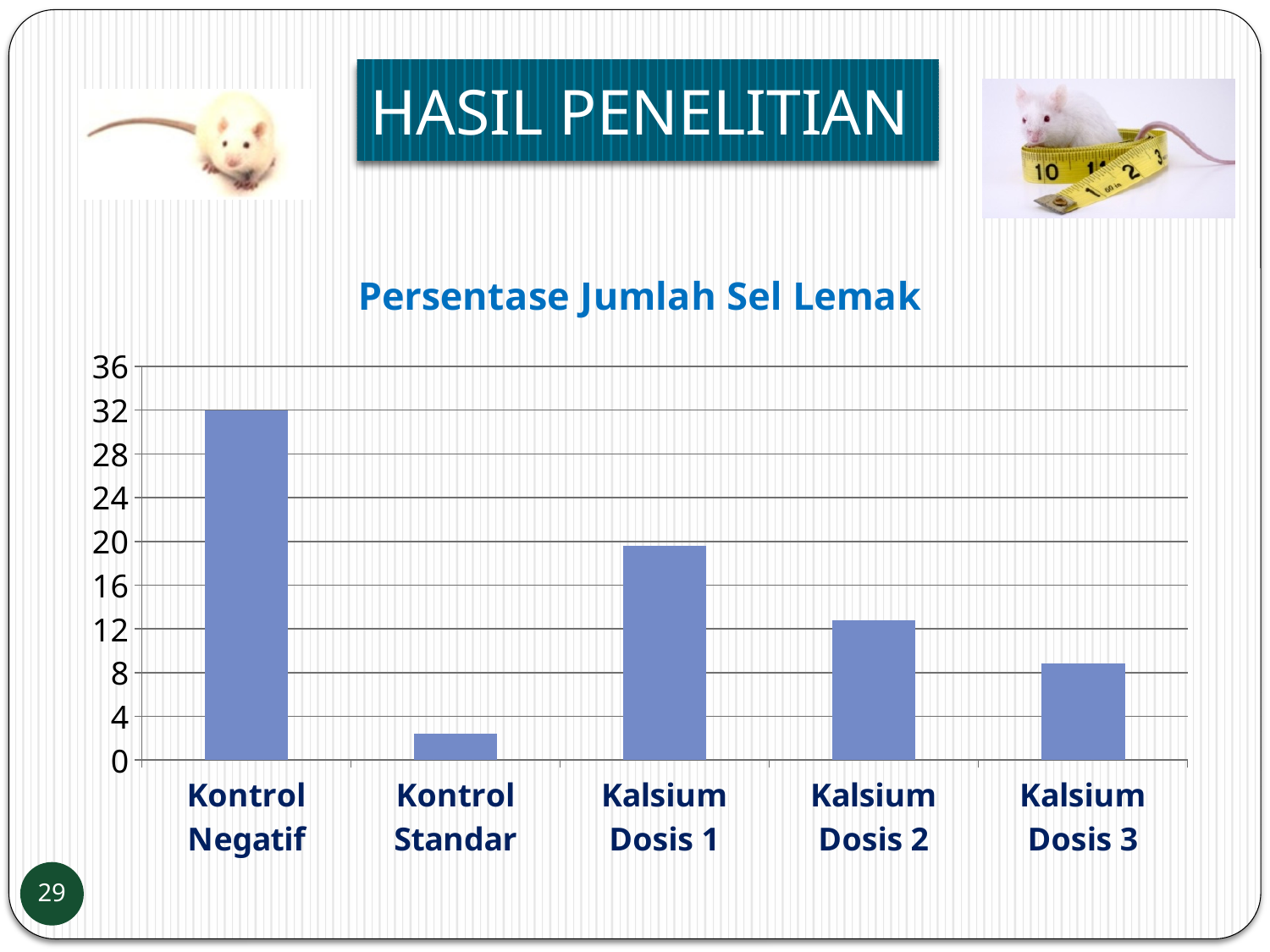
Is the value for Kalsium Dosis 1 greater or less than 16? greater Which category has the lowest value in the chart? Kontrol Standar Which category has the highest value in the chart? Kontrol Negatif Which is larger, the value for Kalsium Dosis 1 or the value for Kalsium Dosis 3? Kalsium Dosis 1 Do the values rise or fall from Kalsium Dosis 1 to Kalsium Dosis 3? fall Is the value for Kalsium Dosis 2 greater or less than 16? less How many categories are shown on the x axis of the chart? 5 Is the value for Kontrol Standar greater or less than 4? less What is the value for Kontrol Negatif? 32 What is the title of the chart? Persentase Jumlah Sel Lemak What kind of chart is shown on the slide? bar chart